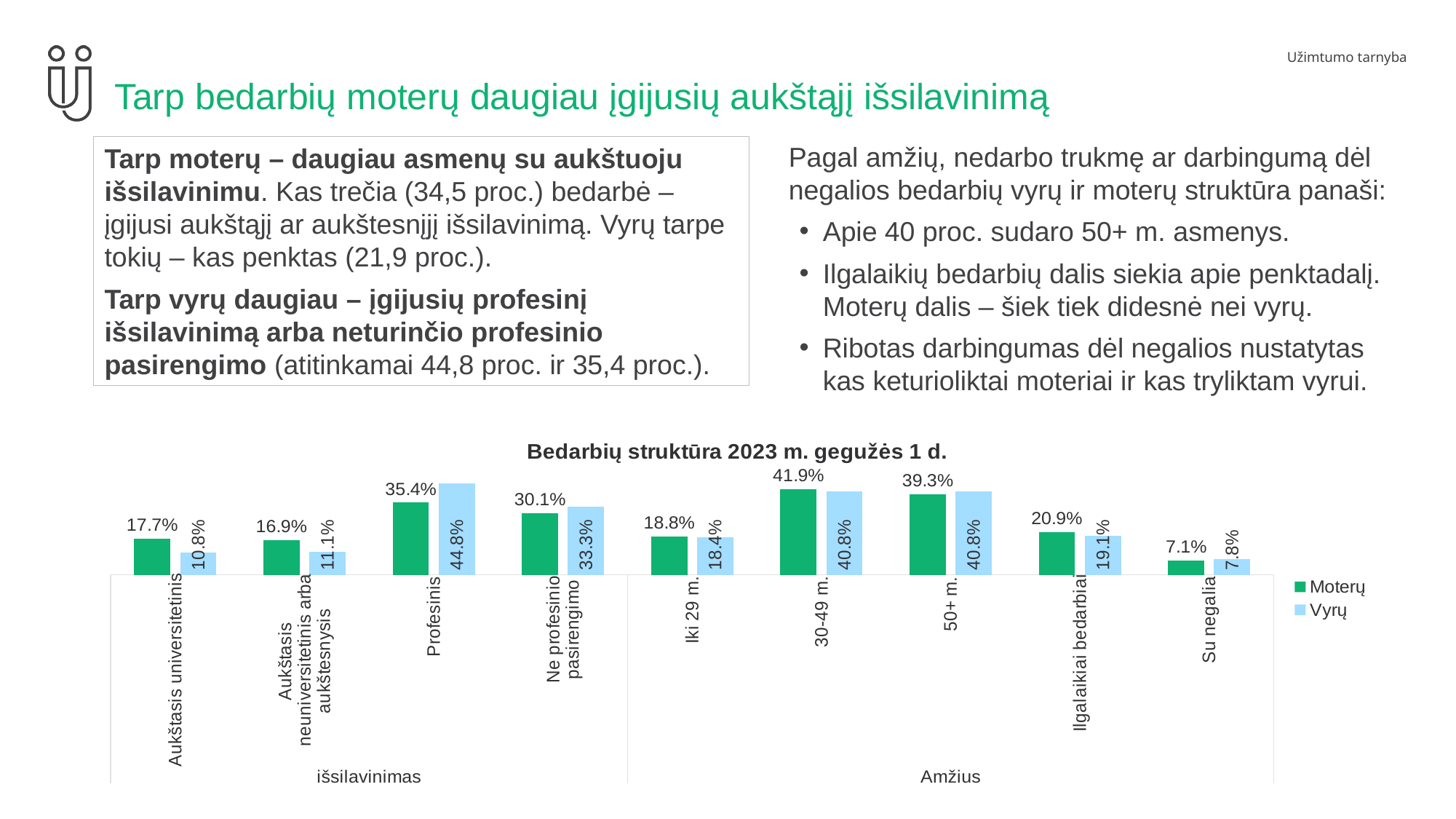
Which colour represents the Vyrų series in the chart? light blue What is the title of the chart? Bedarbių struktūra 2023 m. gegužės 1 d. What is the Vyrų value for Aukštasis universitetinis? 10.8% What type of chart is shown on the slide? bar chart What is the Vyrų value for 50+ m.? 40.8% For Aukštasis universitetinis, which is larger: the Moterų value or the Vyrų value? Moterų Which category has the lowest Vyrų value? Su negalia What is the Moterų value for Profesinis? 35.4% How many series does the chart legend list? 2 What is the difference between the Vyrų and Moterų values for Profesinis? 9.4% Which category has the highest Moterų value? 30-49 m. How many categories are shown along the x axis of the chart? 9